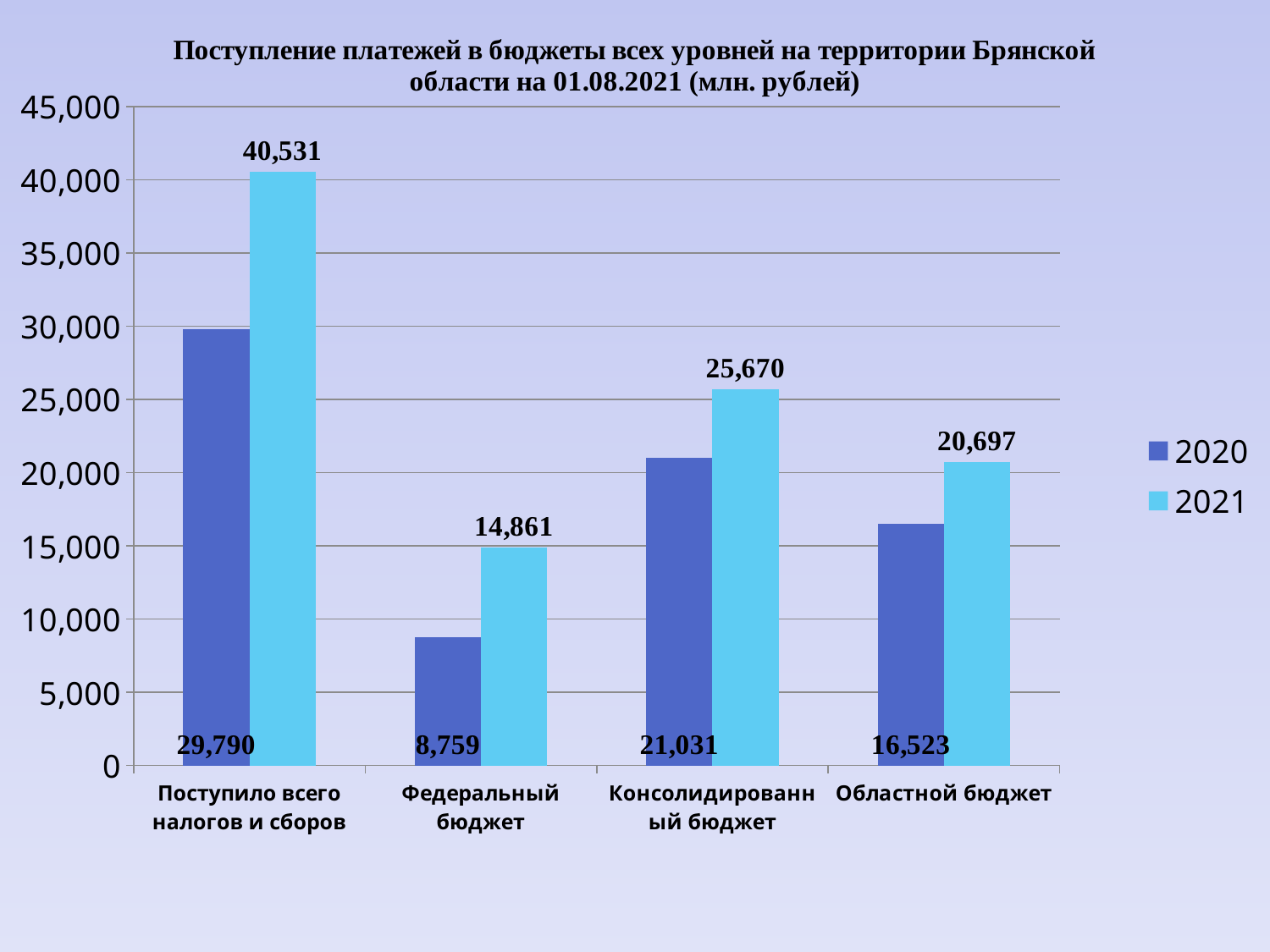
Which category has the lowest 2021 value? Федеральный бюджет What is the difference between the 2021 and 2020 values for Федеральный бюджет? 6,102 What kind of chart is shown on the slide? Bar chart How many series does the legend list? 2 Which category has the highest 2020 value? Поступило всего налогов и сборов What is the 2020 value for Федеральный бюджет? 8,759 How many categories are shown on the x axis? 4 What is the 2021 value for Консолидированный бюджет? 25,670 What is the 2020 value for Областной бюджет? 16,523 What is the difference between the 2021 and 2020 values for Поступило всего налогов и сборов? 10,741 Which is larger: the 2020 value for Консолидированный бюджет or the 2021 value for Областной бюджет? 2020 value for Консолидированный бюджет What is the 2021 value for Поступило всего налогов и сборов? 40,531